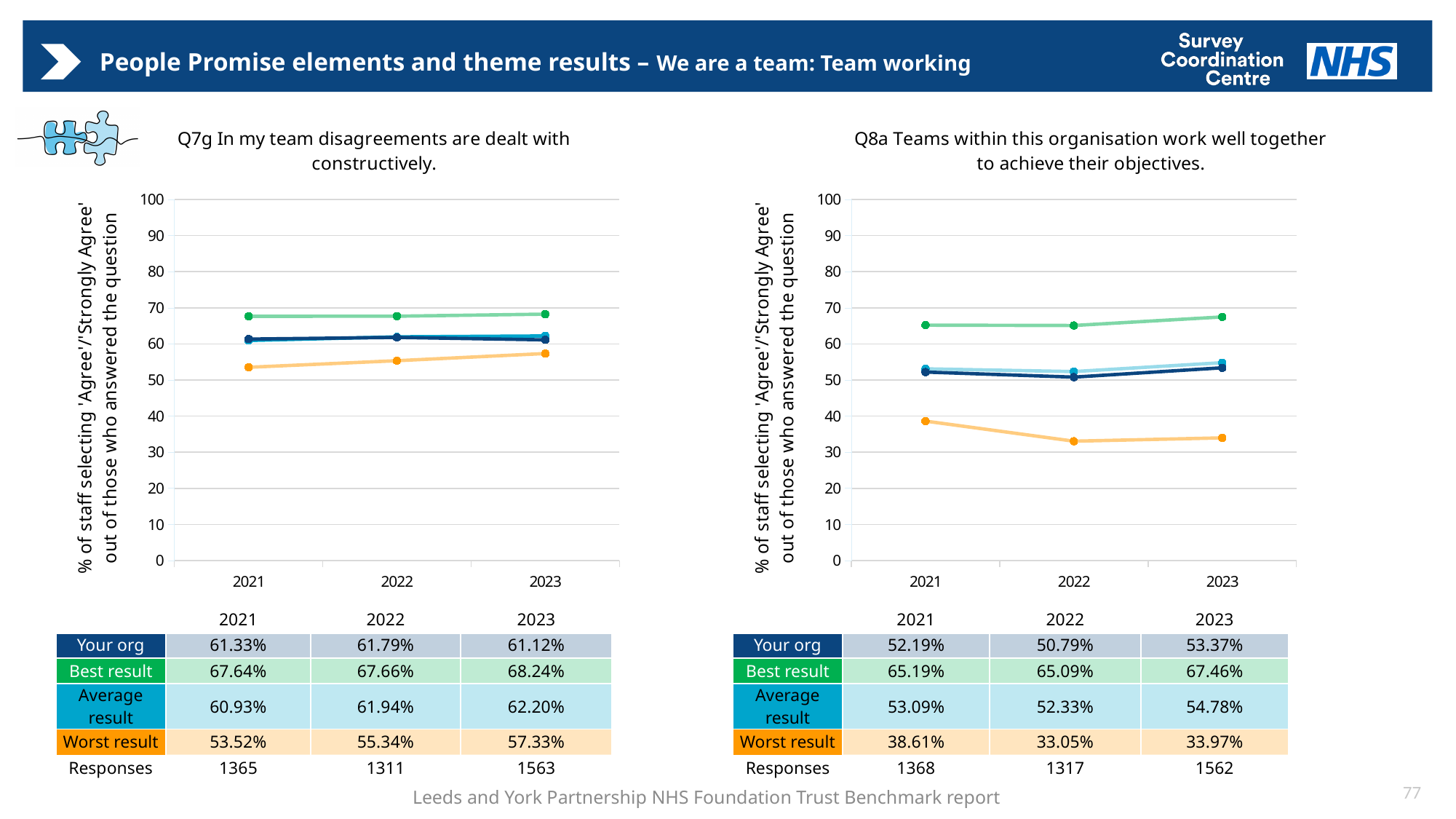
In the Q8a chart, what is the 'Best result' value for 2023? 67.46% In the Q8a chart, what is the 'Worst result' value for 2021? 38.61% In the Q7g chart, does the 'Worst result' line rise or fall from 2021 to 2023? rise In the Q7g chart, what is the 'Your org' value for 2022? 61.79% How many years are plotted on the x axis of the Q7g chart? 3 How many series are plotted in the Q8a chart? 4 In the Q8a chart, which is larger in 2023: the 'Average result' or the 'Your org' value? Average result What kind of chart is used for Q8a? line chart In the Q7g chart, what is the difference between the 'Best result' and 'Your org' values for 2023? 7.12% In the Q8a chart, which year has the lowest 'Your org' value? 2022 In the Q8a chart, is the 'Worst result' value for 2022 greater or less than 40? less In the Q7g chart, which year has the highest 'Worst result' value? 2023